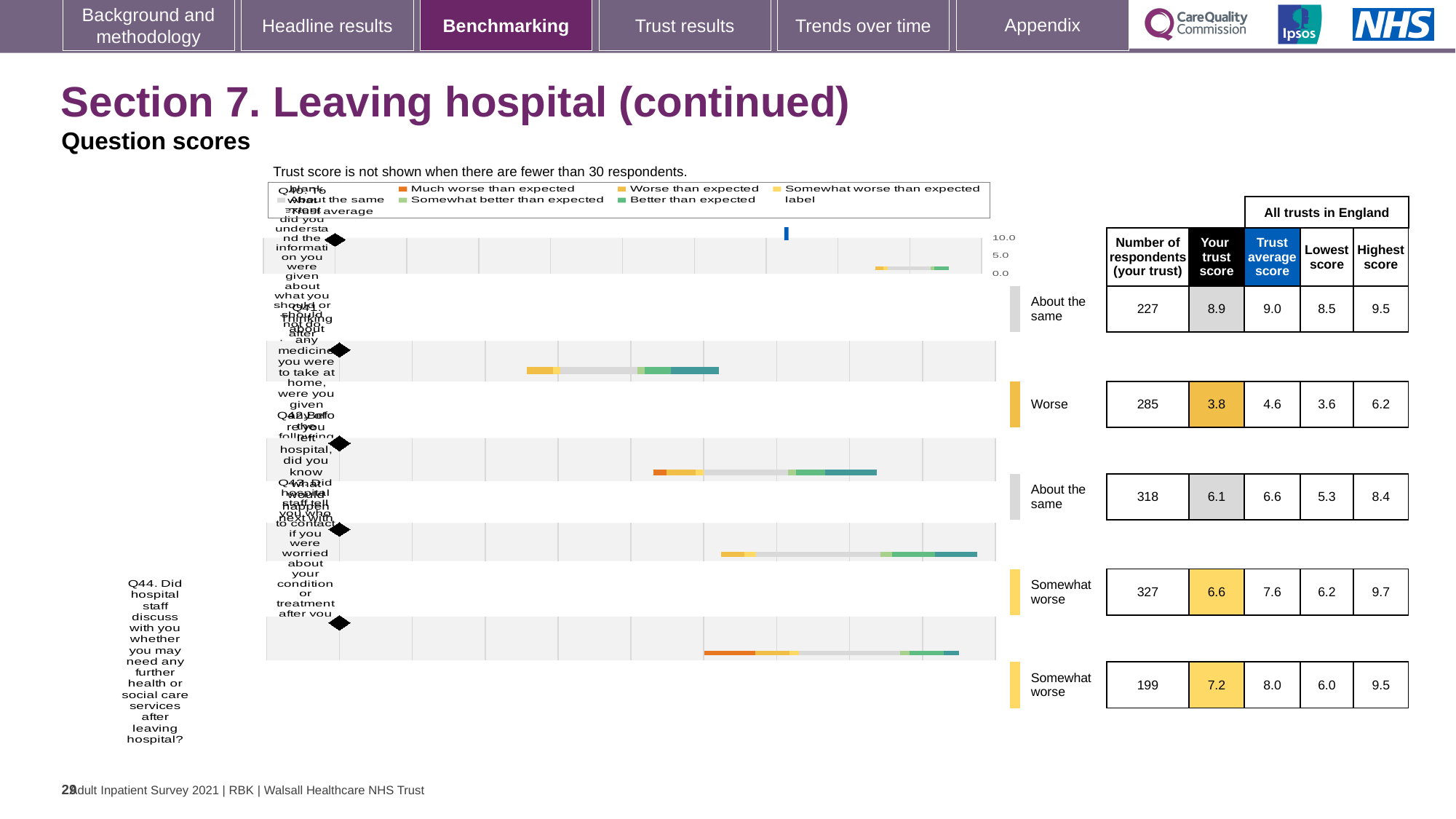
In the row rated 'Worse' (285 respondents), what is the trust score? 3.8 What is the trust average score for Q44? 8.0 Which row of the table has the lowest trust score? The row rated Worse (3.8) Which row of the table has the highest number of respondents? The row with 327 respondents (rated Somewhat worse) How many respondents answered Q44 at this trust? 199 What kind of chart is shown on the slide? Bar chart What is the difference between the trust average score and the trust score in the row rated 'Worse' (285 respondents)? 0.8 What is the trust score for Q44 (Did hospital staff discuss with you whether you may need any further health or social care services after leaving hospital?)? 7.2 What is the highest score across all trusts in England for Q44? 9.5 In the first row of the table (227 respondents), what is the trust score? 8.9 In the row rated 'Worse' (285 respondents), what is the lowest score across all trusts in England? 3.6 Is the trust score for Q44 larger or smaller than the trust average score for Q44? smaller